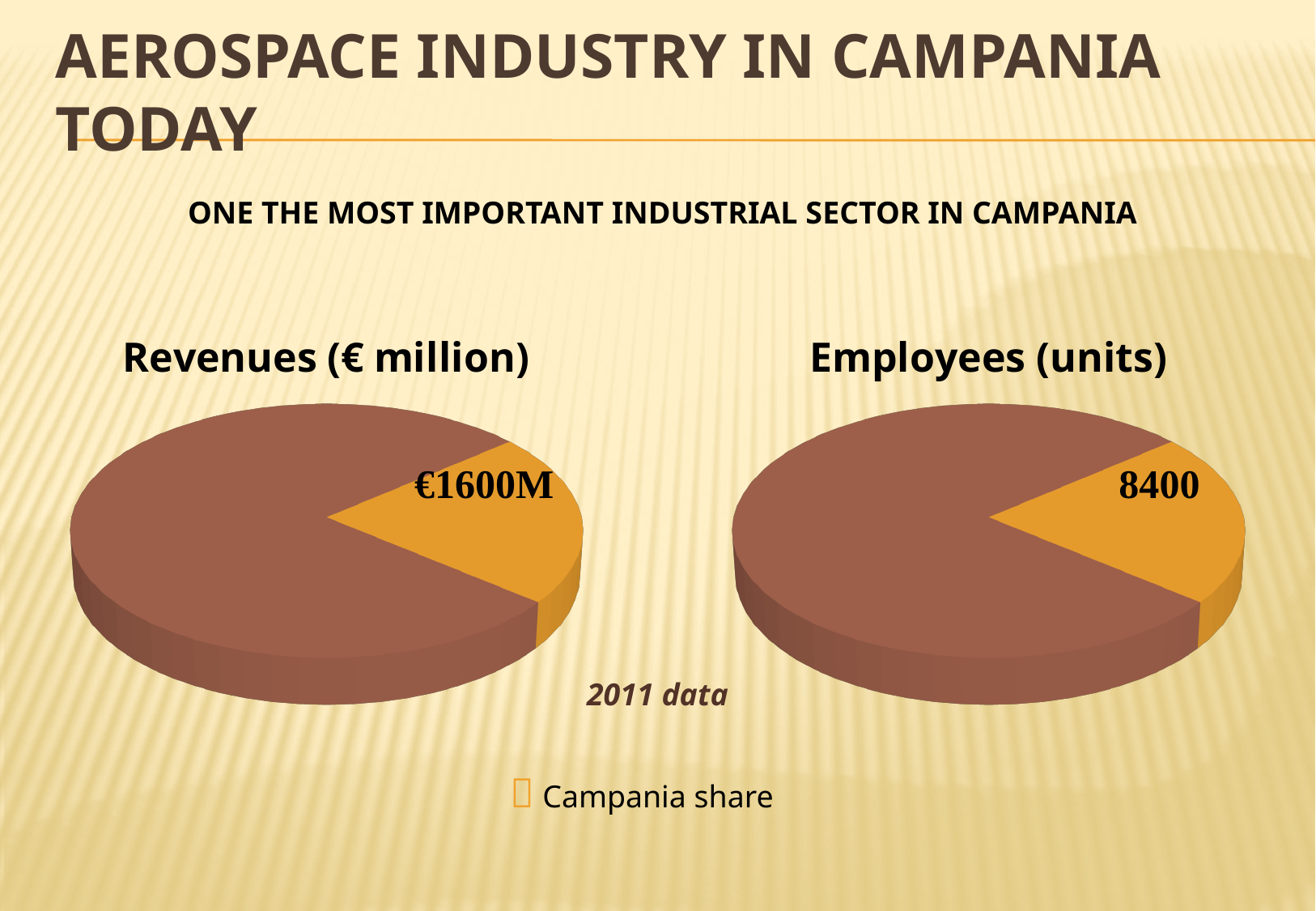
In the Revenues (€ million) chart, which slice is larger, the orange Campania share slice or the brown slice? The brown slice How many slices does the Revenues (€ million) pie chart have? 2 What kind of chart is the Revenues (€ million) chart? Pie chart How many entries does the legend below the charts list? 1 In the Employees (units) chart, which slice is larger, the orange Campania share slice or the brown slice? The brown slice What kind of chart is the Employees (units) chart? Pie chart In the Employees (units) chart, what value is labelled on the Campania share slice? 8400 What is the legend entry shown below the two pie charts? Campania share In the Revenues (€ million) chart, what value is labelled on the Campania share slice? €1600M What is the title of the pie chart on the right of the slide? Employees (units) How many slices does the Employees (units) pie chart have? 2